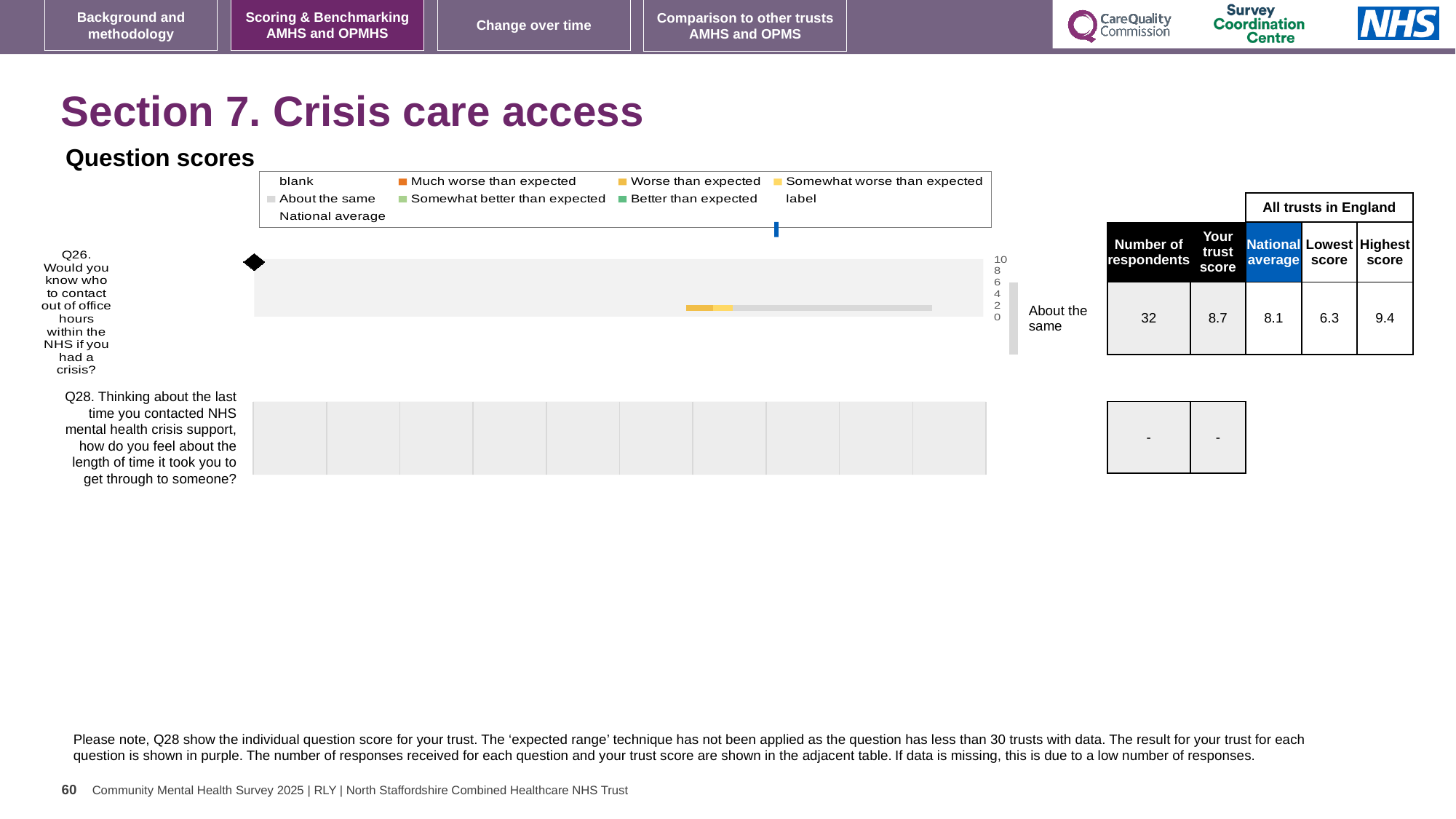
What is the lowest score among all trusts in England for Q26? 6.3 Which benchmark category is the trust's Q26 score placed in? About the same What is the highest score among all trusts in England for Q26? 9.4 What is the difference between the highest and lowest scores for Q26 across all trusts in England? 3.1 Which is larger for Q26: the trust score or the national average? Trust score What is the trust score for Q26 (Would you know who to contact out of office hours within the NHS if you had a crisis?)? 8.7 What kind of chart is used to show the question scores? Bar chart Is the trust score for Q26 greater or less than 8? greater How many respondents answered Q26? 32 By how much does the trust score for Q26 exceed the national average? 0.6 What is the national average score for Q26? 8.1